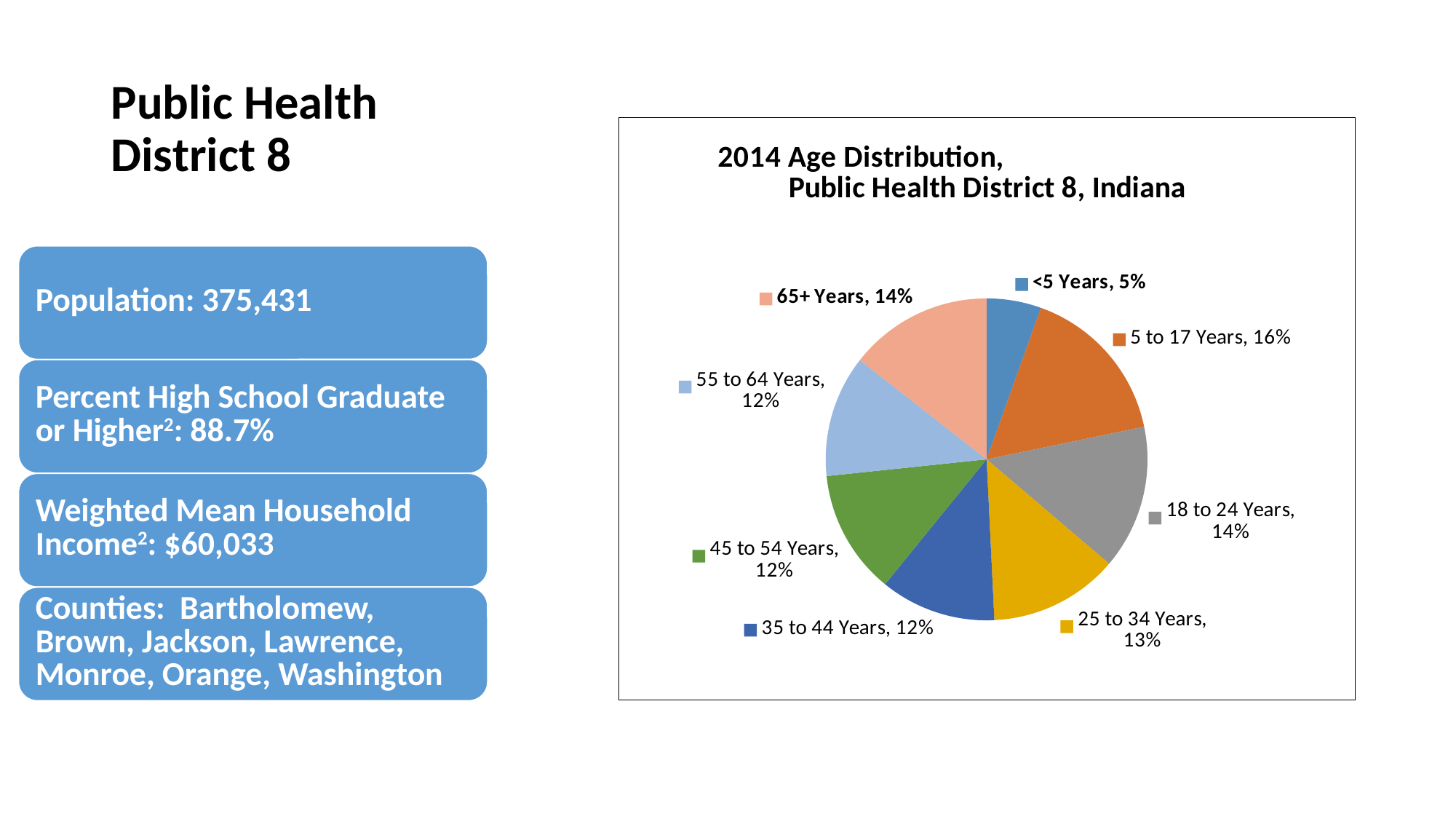
What percentage of the population is in the 25 to 34 Years group? 13% Which age group has the smallest share of the pie? <5 Years What percentage of the population is in the <5 Years group? 5% What type of chart is shown on the slide? Pie chart Which is larger, the share for 25 to 34 Years or the share for 35 to 44 Years? 25 to 34 Years What is the title of the chart? 2014 Age Distribution, Public Health District 8, Indiana How many age groups are shown in the pie chart? 8 What is the combined share of the 65+ Years and 55 to 64 Years groups? 26% What percentage of the population is in the 18 to 24 Years group? 14% What is the difference in percentage points between the 5 to 17 Years group and the <5 Years group? 11 What percentage of the population is in the 5 to 17 Years group? 16% Which age group has the largest share of the pie? 5 to 17 Years